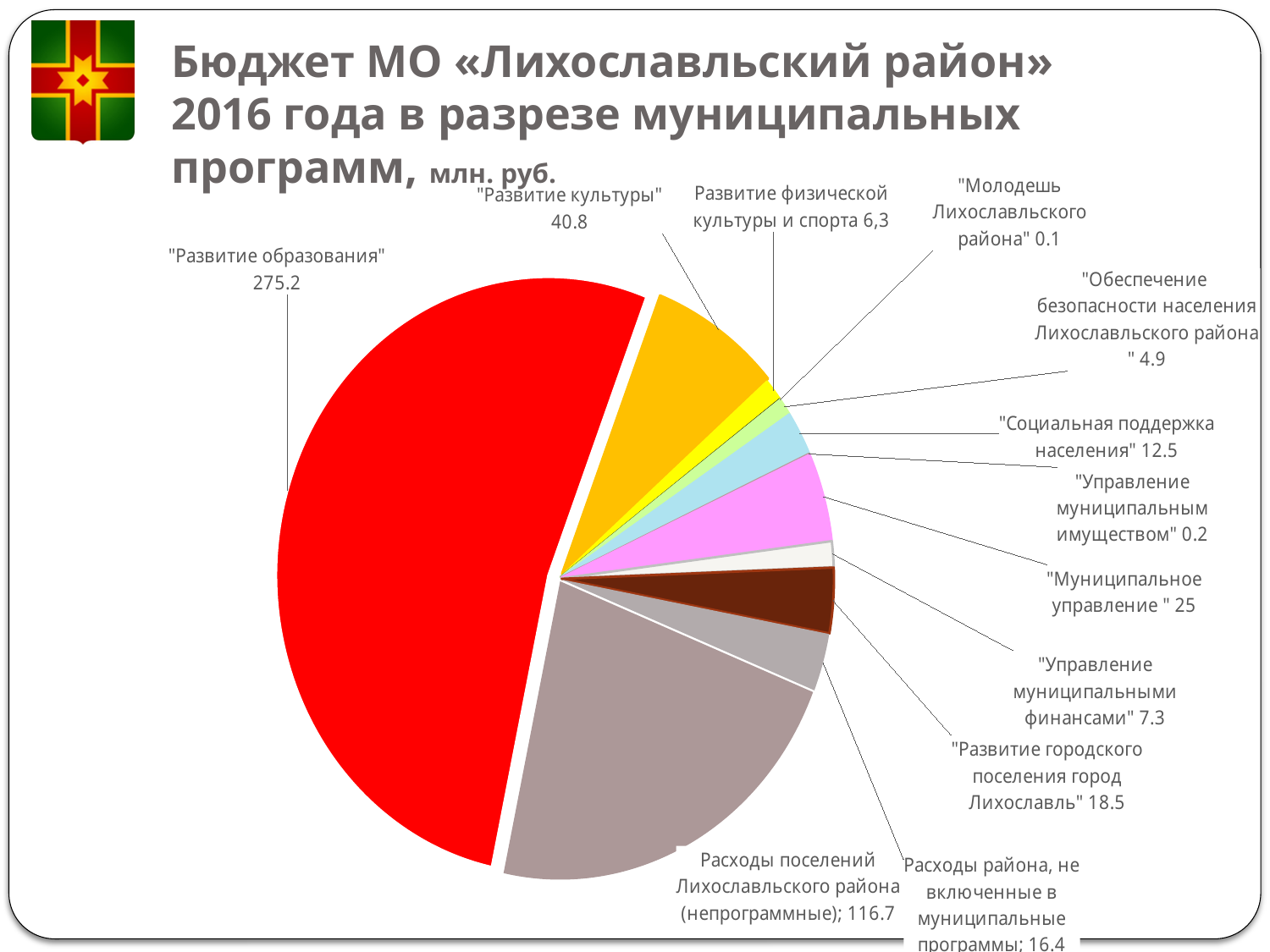
What is the value for "Развитие городского поселения город Лихославль"? 18.5 What kind of chart is shown on the slide? pie chart Which program has the largest slice of the pie? "Развитие образования" What is the value for "Развитие культуры"? 40.8 What is the difference between "Развитие культуры" and "Муниципальное управление"? 15.8 What is the value for "Развитие образования"? 275.2 What is the difference between "Развитие образования" and Расходы поселений Лихославльского района (непрограммные)? 158.5 Which program has the smallest value in the pie chart? "Молодешь Лихославльского района" What is the value for "Социальная поддержка населения"? 12.5 What is the value for Расходы поселений Лихославльского района (непрограммные)? 116.7 Which is larger: "Социальная поддержка населения" or "Управление муниципальными финансами"? "Социальная поддержка населения" How many slices does the pie chart have? 12